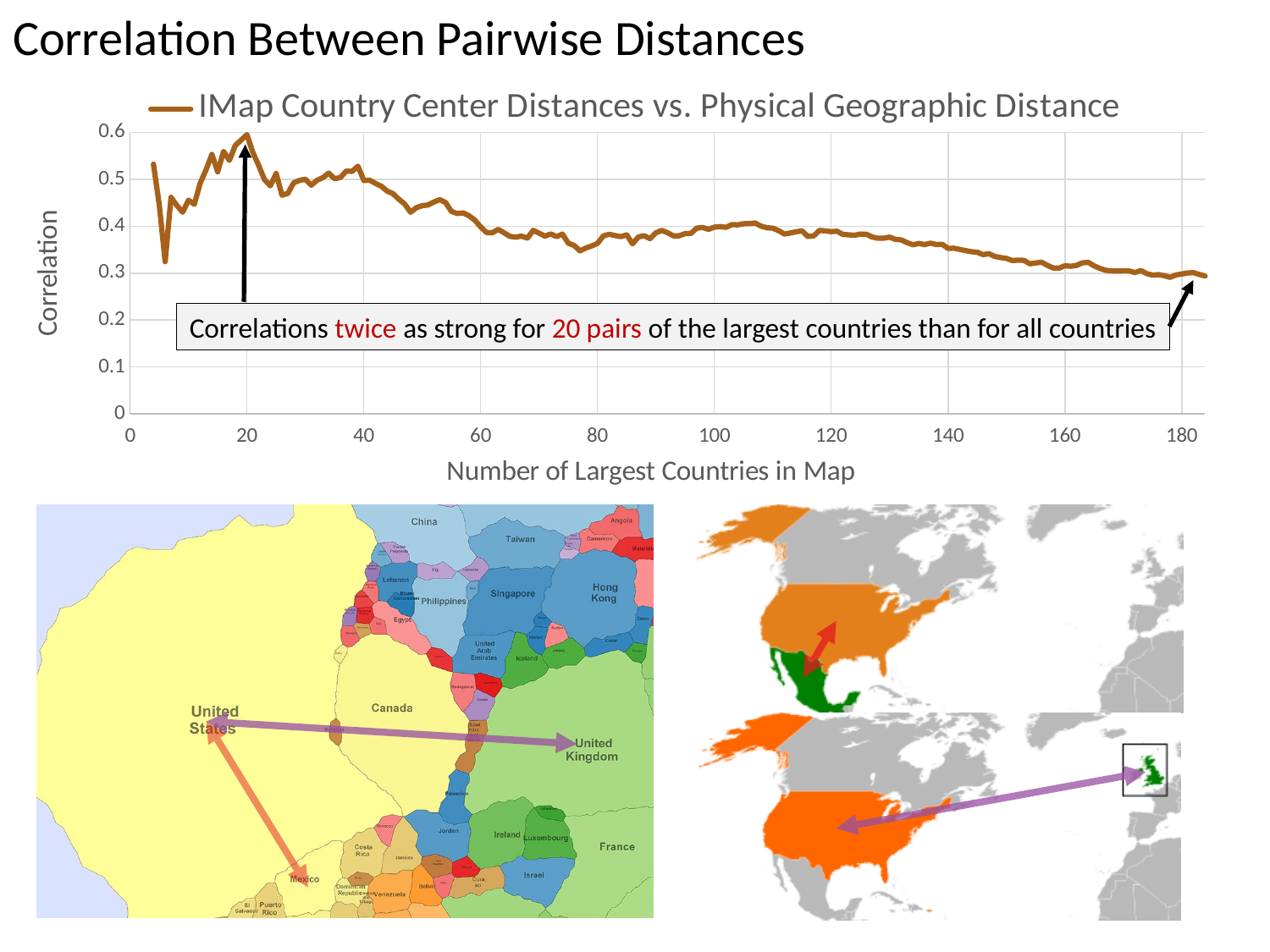
What is the label of the x axis of the chart? Number of Largest Countries in Map Is the correlation at 180 largest countries greater or less than 0.4? less Is the correlation at 100 largest countries greater or less than 0.5? less Is the correlation at 140 largest countries greater or less than 0.3? greater From 20 largest countries onward, does the correlation generally rise or fall as the number of countries increases? fall Which is larger, the correlation at 40 largest countries or at 100 largest countries? 40 How many series does the chart's legend list? 1 What is the legend entry for the plotted series? IMap Country Center Distances vs. Physical Geographic Distance Which is larger, the correlation at 20 largest countries or at 180 largest countries? 20 What kind of chart is shown on the slide? line chart